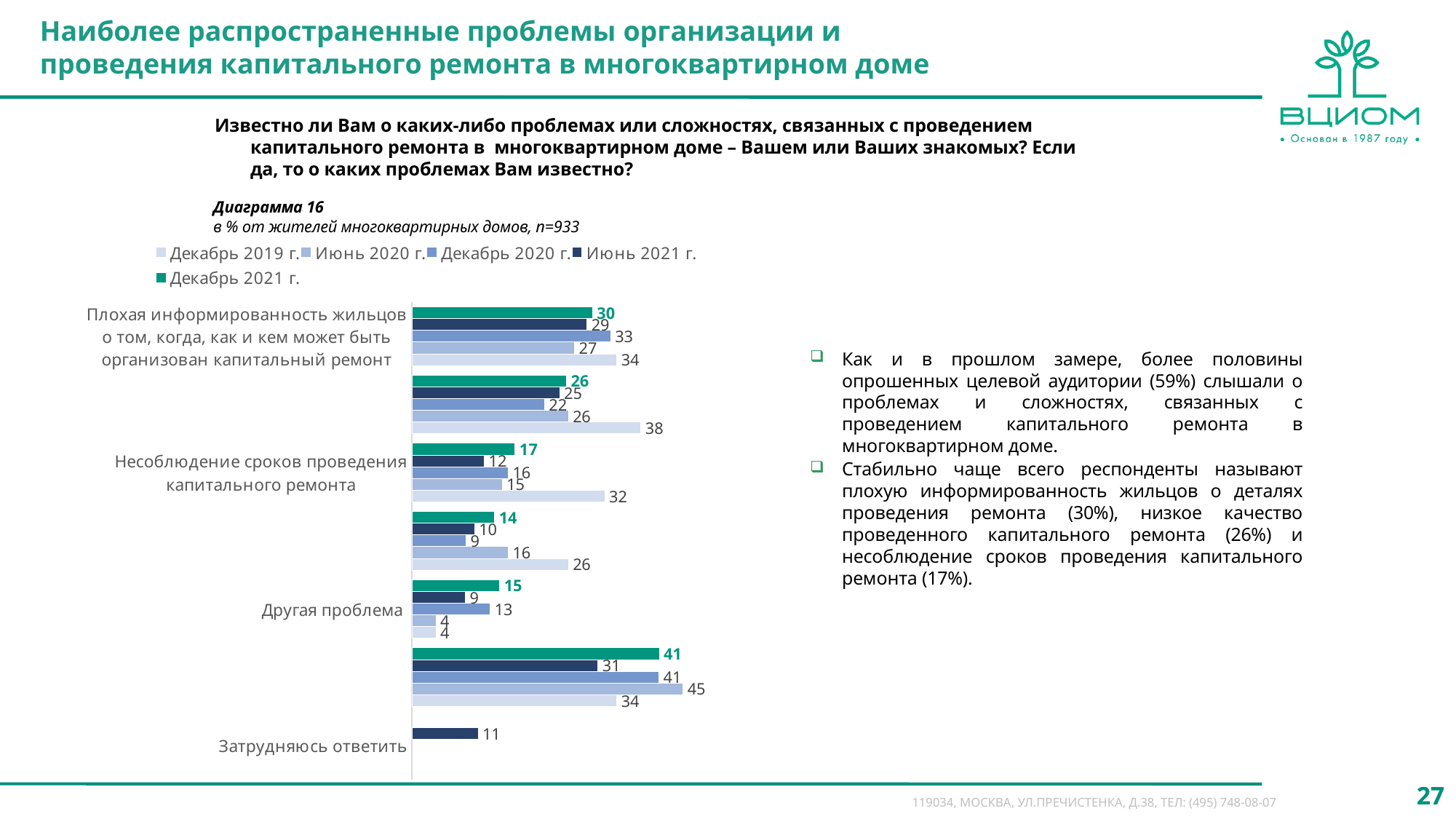
For «Несоблюдение сроков проведения капитального ремонта», which survey wave has the lowest value? Июнь 2021 г. For «Плохая информированность жильцов о том, когда, как и кем может быть организован капитальный ремонт», which survey wave has the highest value? Декабрь 2019 г. What is the first entry in the chart legend? Декабрь 2019 г. What is the value for «Плохая информированность жильцов о том, когда, как и кем может быть организован капитальный ремонт» in Декабрь 2020 г.? 33 How many series does the legend list? 5 What is the value for «Затрудняюсь ответить» in Июнь 2021 г.? 11 What is the value for «Плохая информированность жильцов о том, когда, как и кем может быть организован капитальный ремонт» in Декабрь 2021 г.? 30 For «Несоблюдение сроков проведения капитального ремонта», which is larger: the Декабрь 2021 г. value or the Июнь 2021 г. value? Декабрь 2021 г. What kind of chart is shown on the slide? Bar chart What is the value for «Несоблюдение сроков проведения капитального ремонта» in Декабрь 2019 г.? 32 What is the value for «Другая проблема» in Декабрь 2021 г.? 15 What is the difference between the Декабрь 2019 г. and Декабрь 2021 г. values for «Плохая информированность жильцов о том, когда, как и кем может быть организован капитальный ремонт»? 4